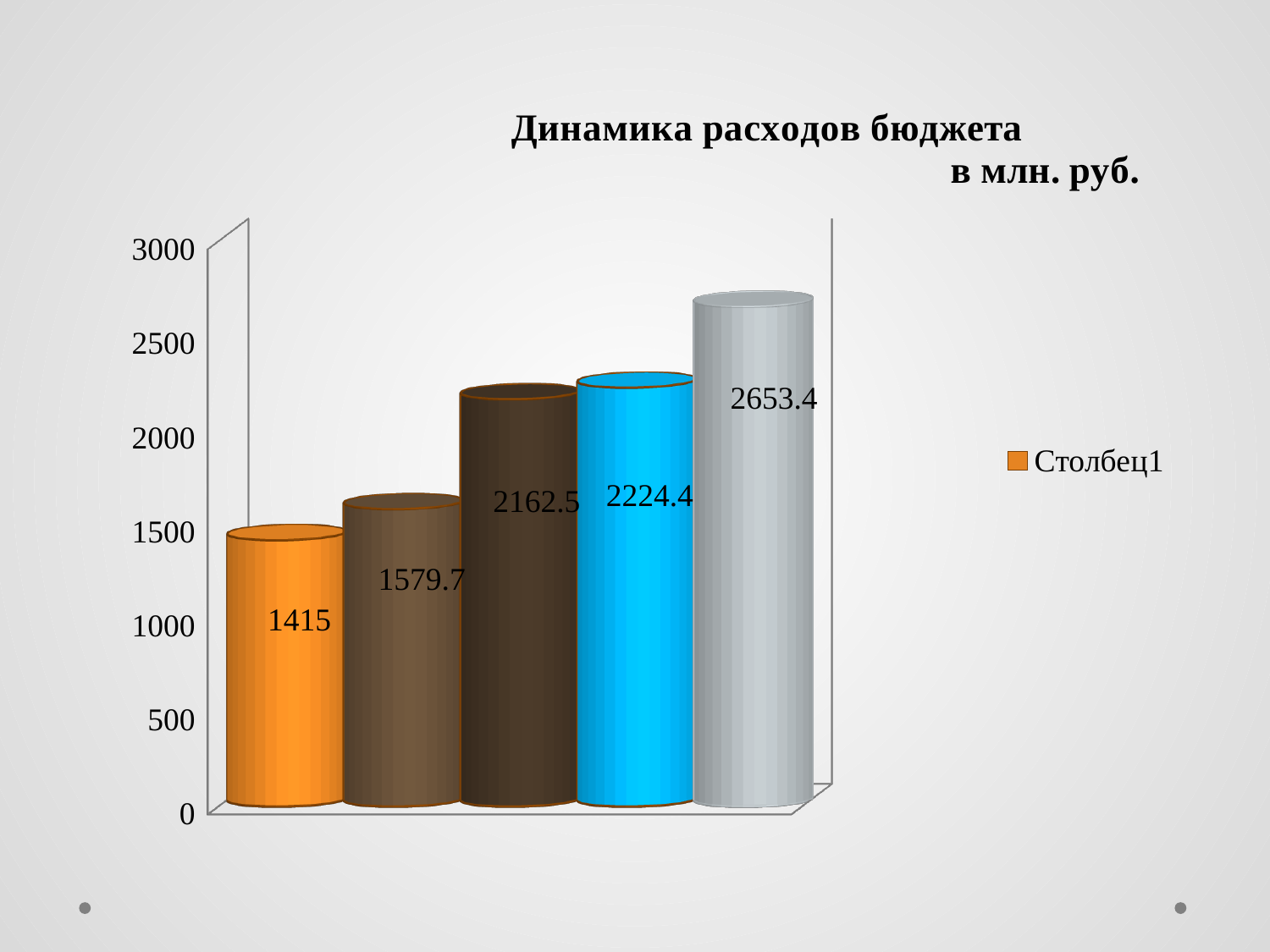
How many bars are plotted in the chart? 5 How many series does the legend list? 1 What is the difference between the last bar (2653.4) and the first bar (1415)? 1238.4 What is the value shown on the light blue bar? 2224.4 What is the value shown on the dark brown (third) bar? 2162.5 What kind of chart is shown on the slide? Bar chart What is the value shown on the first (orange) bar? 1415 Which bar has the highest value? The last (grey) bar, 2653.4 Do the values rise or fall from left to right across the bars? Rise Which bar has the lowest value? The first (orange) bar, 1415 What is the value shown on the last (grey) bar? 2653.4 Which is larger, the value of the second bar or the value of the third bar? The third bar (2162.5)